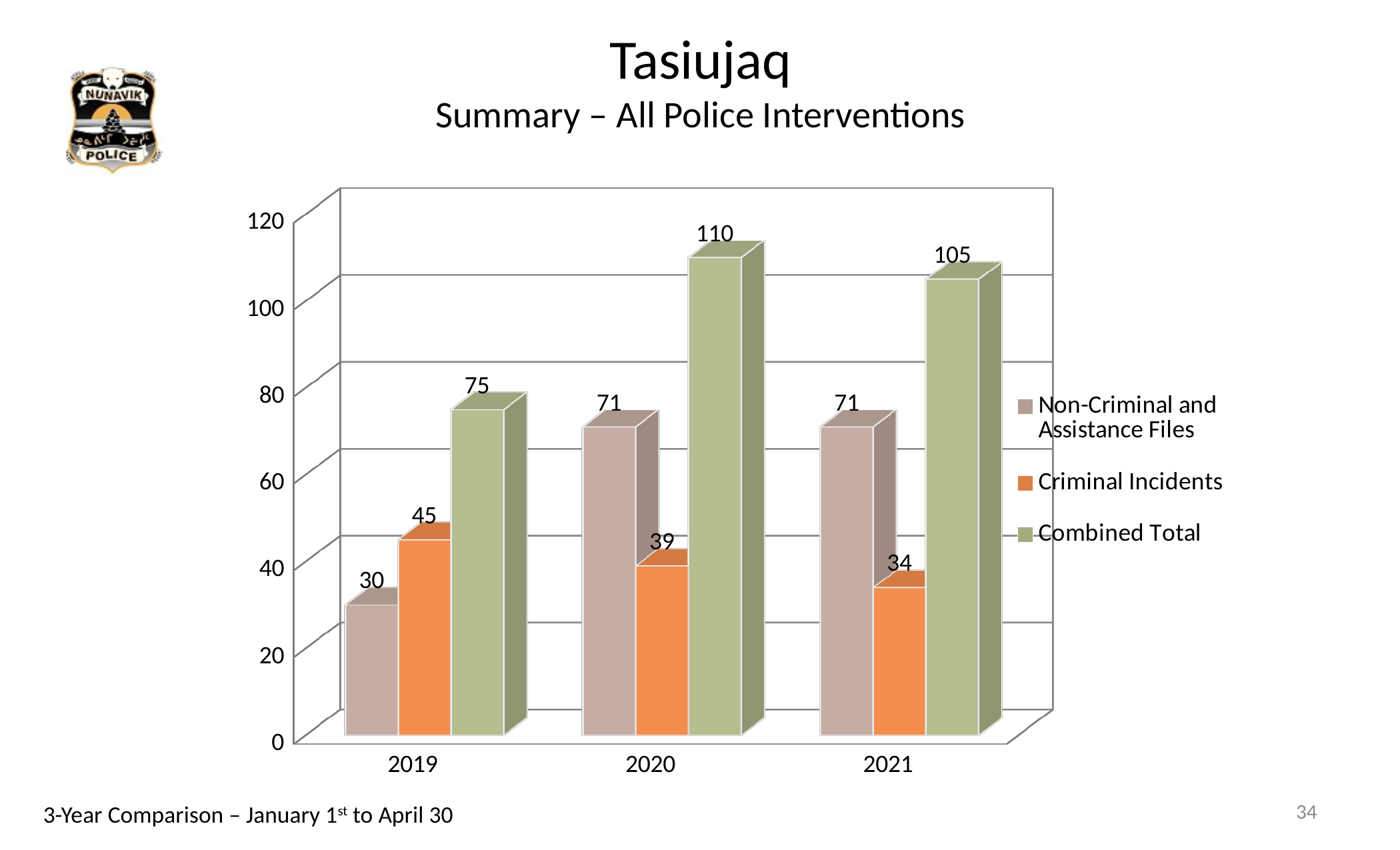
What is the Combined Total for 2021? 105 What kind of chart is shown on the slide? bar chart What is the value for Criminal Incidents in 2020? 39 How many series does the legend list? 3 In which year is the Combined Total highest? 2020 Which is larger: Criminal Incidents in 2019 or Criminal Incidents in 2021? Criminal Incidents in 2019 Is the Combined Total for 2020 greater or less than 100? greater What is the value for Non-Criminal and Assistance Files in 2019? 30 What is the difference between the Combined Total in 2020 and in 2019? 35 How many years are shown on the x axis? 3 In which year is the Criminal Incidents value lowest? 2021 Which series is shown in orange in the legend? Criminal Incidents